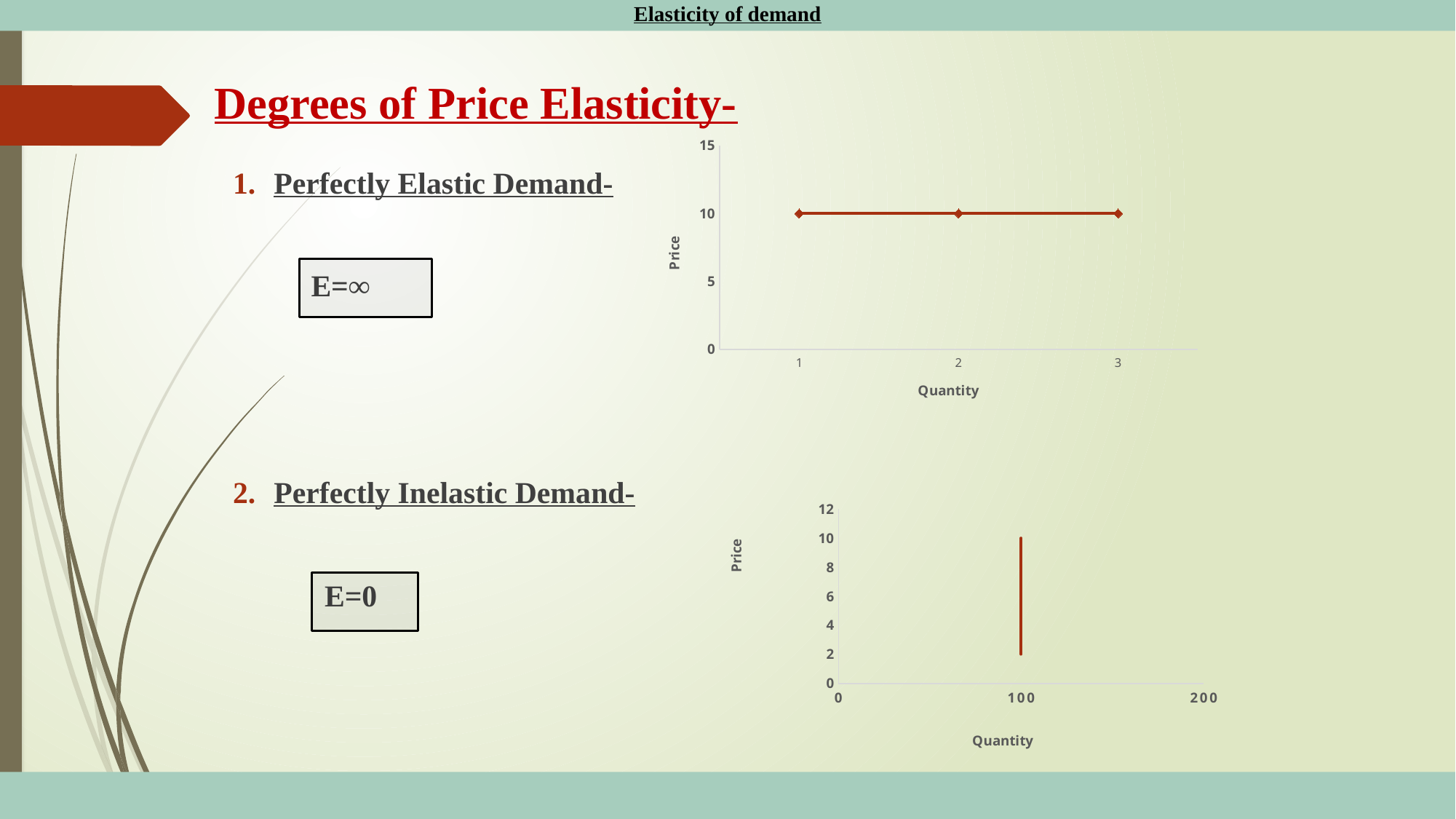
In the top chart (Perfectly Elastic Demand), is the price at quantity 1 greater or less than 5? greater In the bottom chart (Perfectly Inelastic Demand), at what quantity is the vertical line drawn? 100 In the bottom chart (Perfectly Inelastic Demand), what is the highest tick value on the vertical axis? 12 In the top chart (Perfectly Elastic Demand), how many data points are plotted? 3 In the top chart (Perfectly Elastic Demand), what is the price at quantity 2? 10 In the top chart (Perfectly Elastic Demand), what is the price at quantity 3? 10 In the bottom chart (Perfectly Inelastic Demand), is the quantity of the vertical line greater or less than 200? less What is the highest tick value on the vertical axis of the top chart (Perfectly Elastic Demand)? 15 In the bottom chart (Perfectly Inelastic Demand), what is the lowest price the vertical line reaches? 2 What kind of chart is the top chart under 'Perfectly Elastic Demand'? line chart In the bottom chart (Perfectly Inelastic Demand), what is the highest price the vertical line reaches? 10 In the top chart (Perfectly Elastic Demand), does the price rise, fall or stay constant as quantity increases from 1 to 3? stays constant